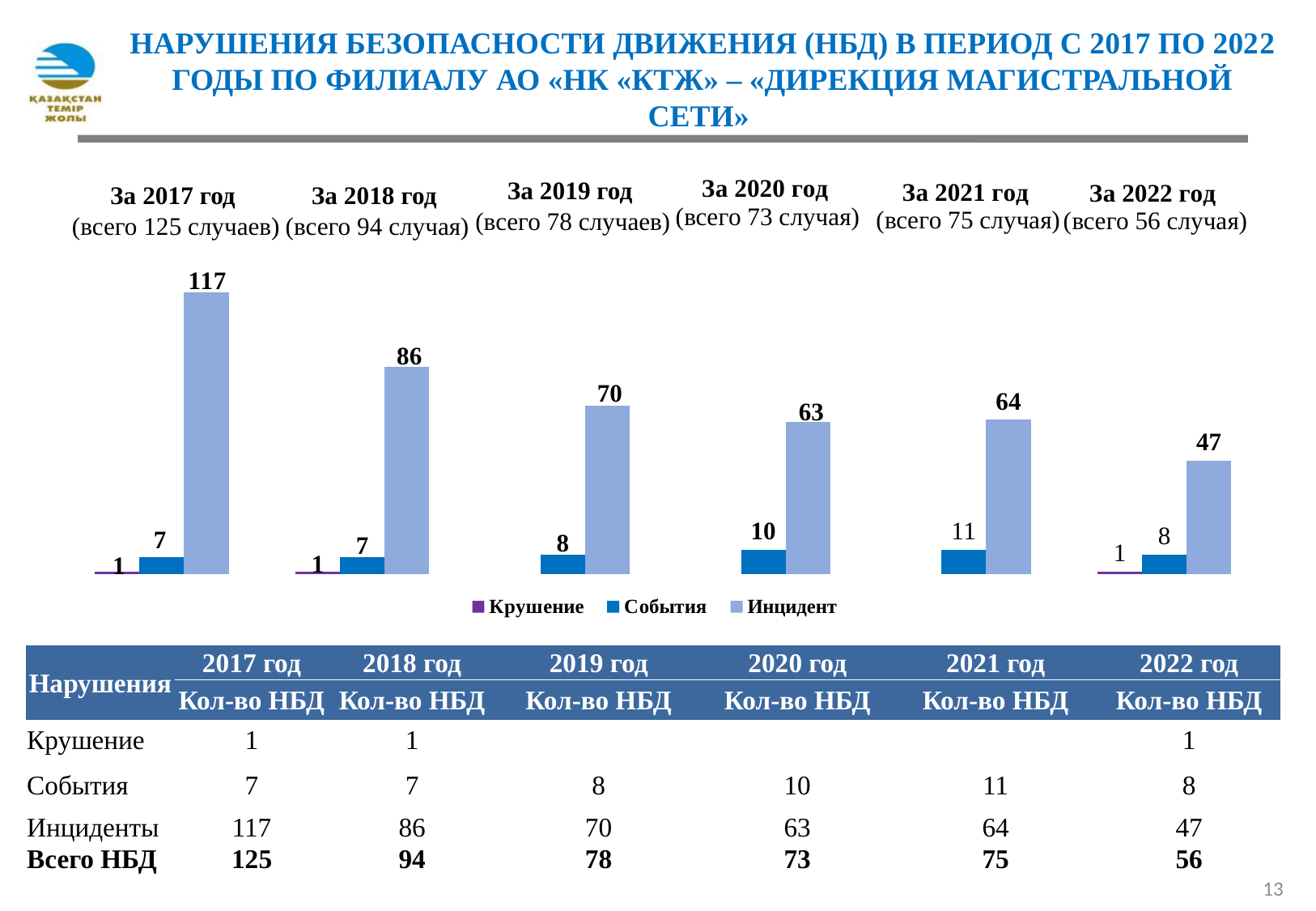
What is the value of Инцидент for 2017 (За 2017 год)? 117 What kind of chart is shown on the slide? Bar chart What is the difference between the Инцидент values for 2018 and 2019? 16 How many year groups are shown on the chart? 6 How many series does the legend list? 3 Which is larger, the Инцидент value for 2020 or for 2021? 2021 What is the value of Инцидент for 2022 (За 2022 год)? 47 What is the total number of cases (всего) stated for 2019? 78 случаев In which year is the Инцидент bar the highest? 2017 Does the Инцидент series generally rise or fall from 2017 to 2022? Fall In which year is the Инцидент bar the lowest? 2022 What is the value of События for 2021 (За 2021 год)? 11